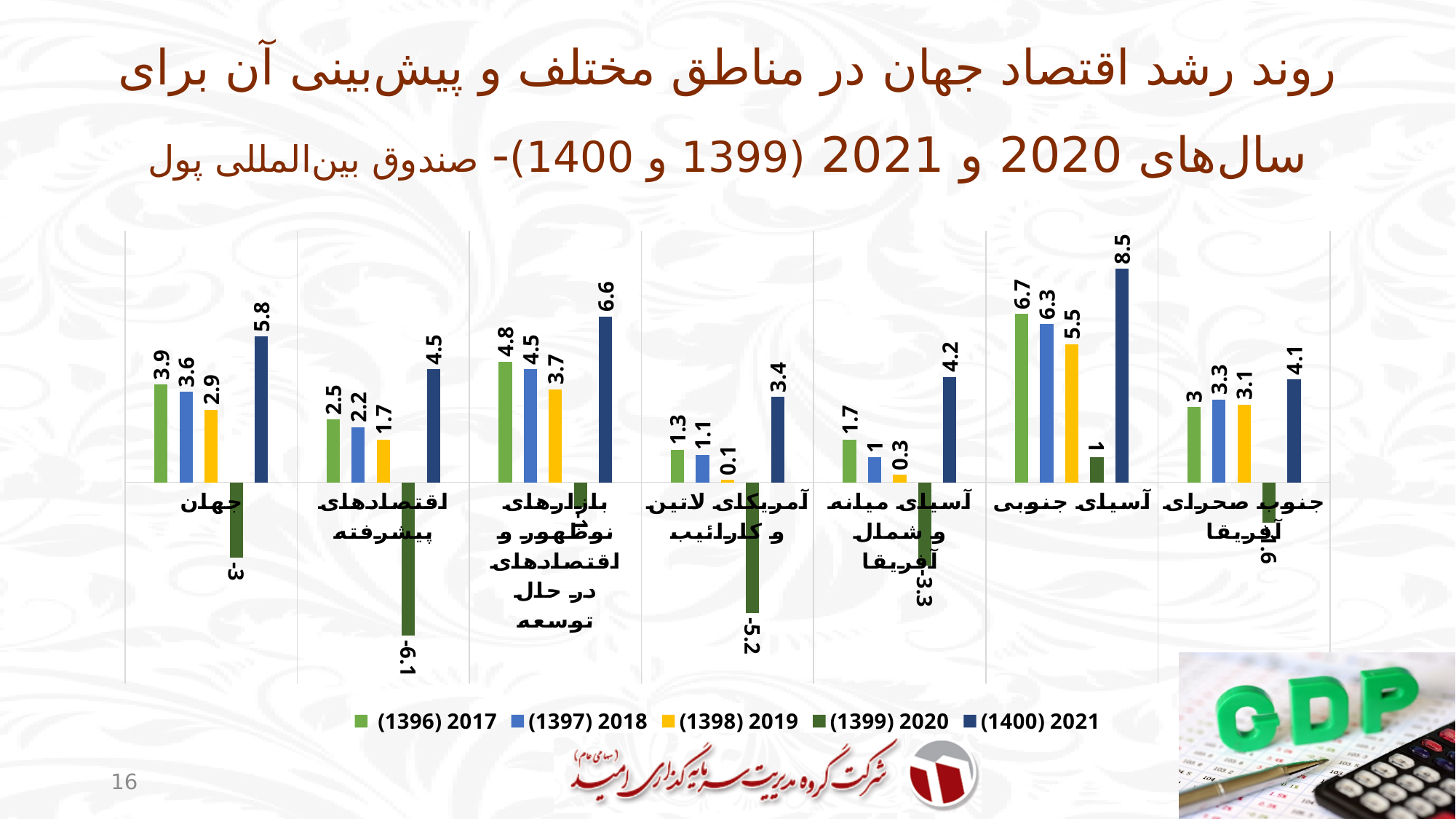
Which is larger for جنوب صحرای آفریقا (Sub-Saharan Africa): the (1396) 2017 value or the (1397) 2018 value? (1397) 2018 What is the value for اقتصادهای پیشرفته (advanced economies) in the (1399) 2020 series? -6.1 Which legend entry is shown in yellow? (1398) 2019 What kind of chart is shown on the slide? bar chart How many region categories are shown on the x axis? 7 For آسیای میانه و شمال آفریقا (Middle East and North Africa), do the values fall from 2017 to 2019? yes, they fall What is the value for جهان (World) in the (1400) 2021 series? 5.8 How many series does the legend list? 5 What is the value for آسیای جنوبی (South Asia) in the (1396) 2017 series? 6.7 Which region has the highest value in the (1400) 2021 series? آسیای جنوبی (South Asia) Which region has the lowest value in the (1399) 2020 series? اقتصادهای پیشرفته (advanced economies) What is the difference between the (1400) 2021 and (1398) 2019 values for آمریکای لاتین و کارائیب (Latin America and the Caribbean)? 3.3